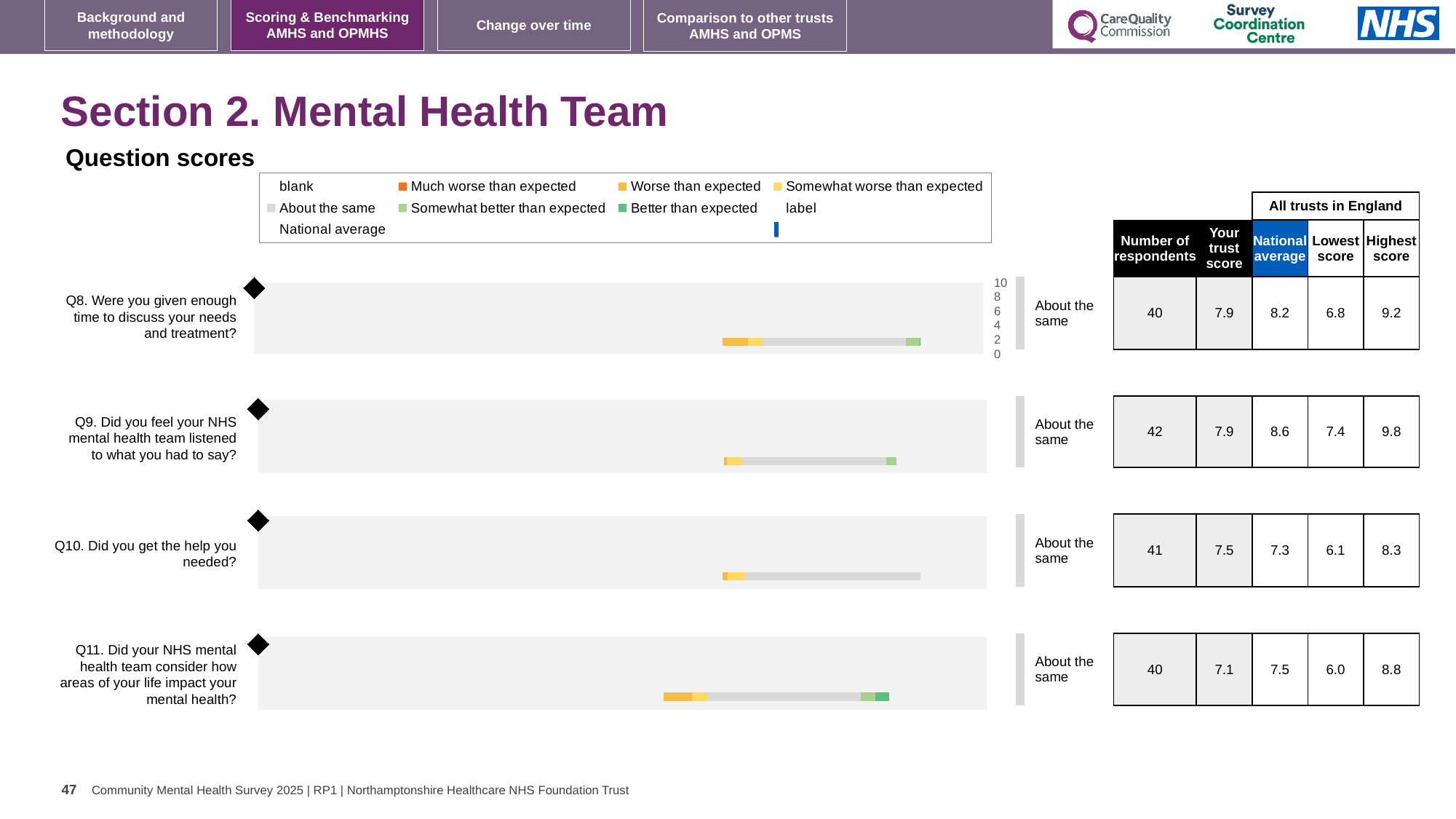
What is the lowest score among all trusts in England for Q10? 6.1 What is the national average score for Q9 (Did you feel your NHS mental health team listened to what you had to say)? 8.6 Which question has the highest national average score on this slide? Q9 How many questions are charted on this slide? 4 What benchmark category is shown next to the Q9 chart? About the same How many respondents answered Q10 (Did you get the help you needed)? 41 What is the highest score among all trusts in England for Q11 (Did your NHS mental health team consider how areas of your life impact your mental health)? 8.8 What kind of chart is used to show the question scores? Bar chart What is the 'Your trust score' value for Q8 (Were you given enough time to discuss your needs and treatment)? 7.9 For Q10, which is larger: the trust score or the national average? Trust score Which question has the lowest 'Your trust score' on this slide? Q11 What is the difference between the national average and the trust score for Q8? 0.3